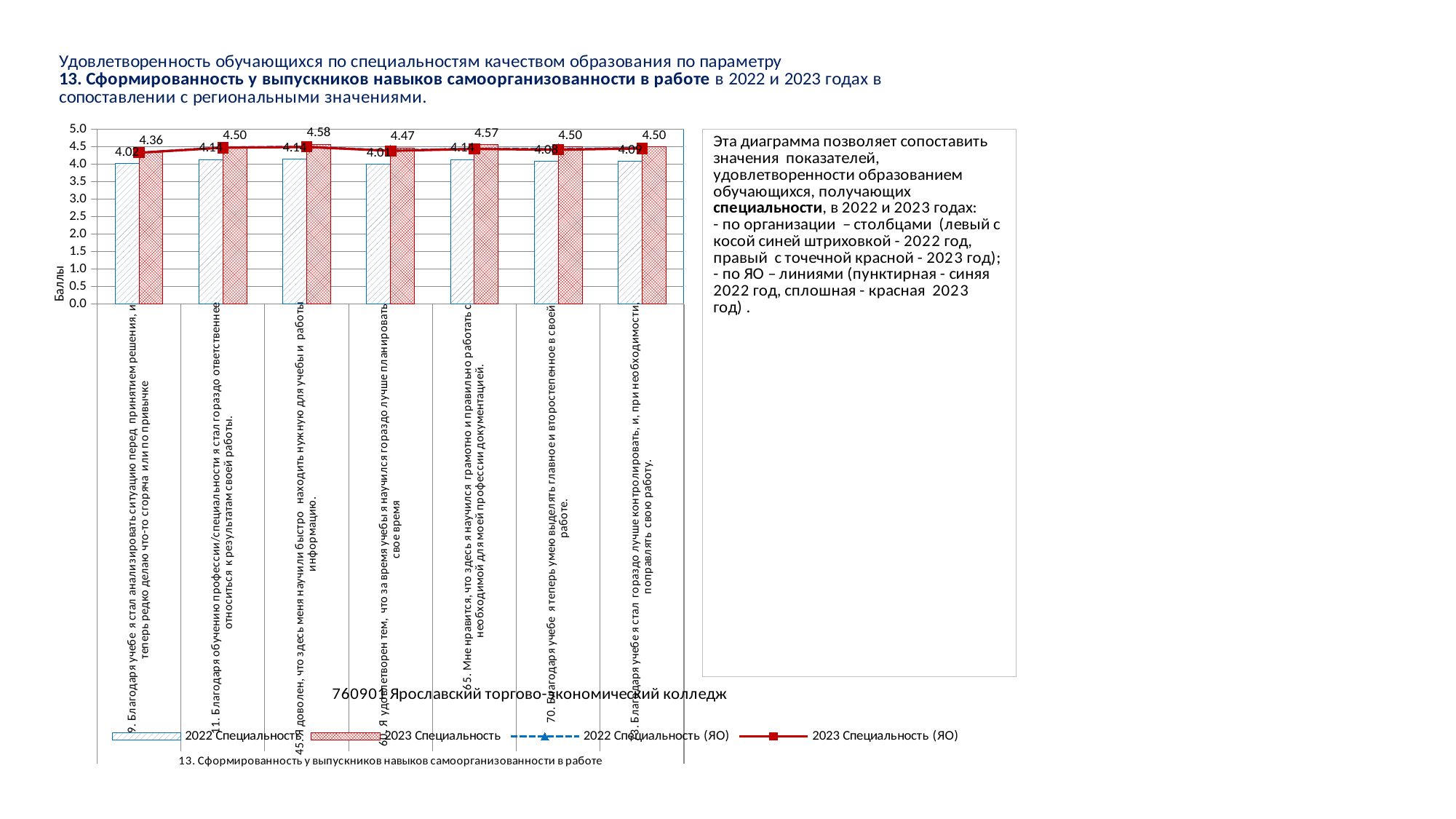
What is the label of the vertical axis of the chart? Баллы What is the 2023 Специальность value for category 45 (Я доволен, что здесь меня научили быстро находить нужную информацию)? 4.58 How many categories (questions) are shown on the x axis of the chart? 7 How many series does the chart legend list? 4 What is the 2023 Специальность value for category 9 (Благодаря учебе я стал анализировать ситуацию перед принятием решения)? 4.36 Which category has the highest 2023 Специальность value? 45. Я доволен, что здесь меня научили быстро находить нужную для учебы и работы информацию Is the 2022 Специальность value for category 9 greater or less than 4.5? less What is the difference between the highest and lowest 2023 Специальность values (4.58 and 4.36)? 0.22 Which category has the lowest 2023 Специальность value? 9. Благодаря учебе я стал анализировать ситуацию перед принятием решения What is the 2023 Специальность value for category 65 (Мне нравится, что здесь я научился грамотно и правильно работать с документацией)? 4.57